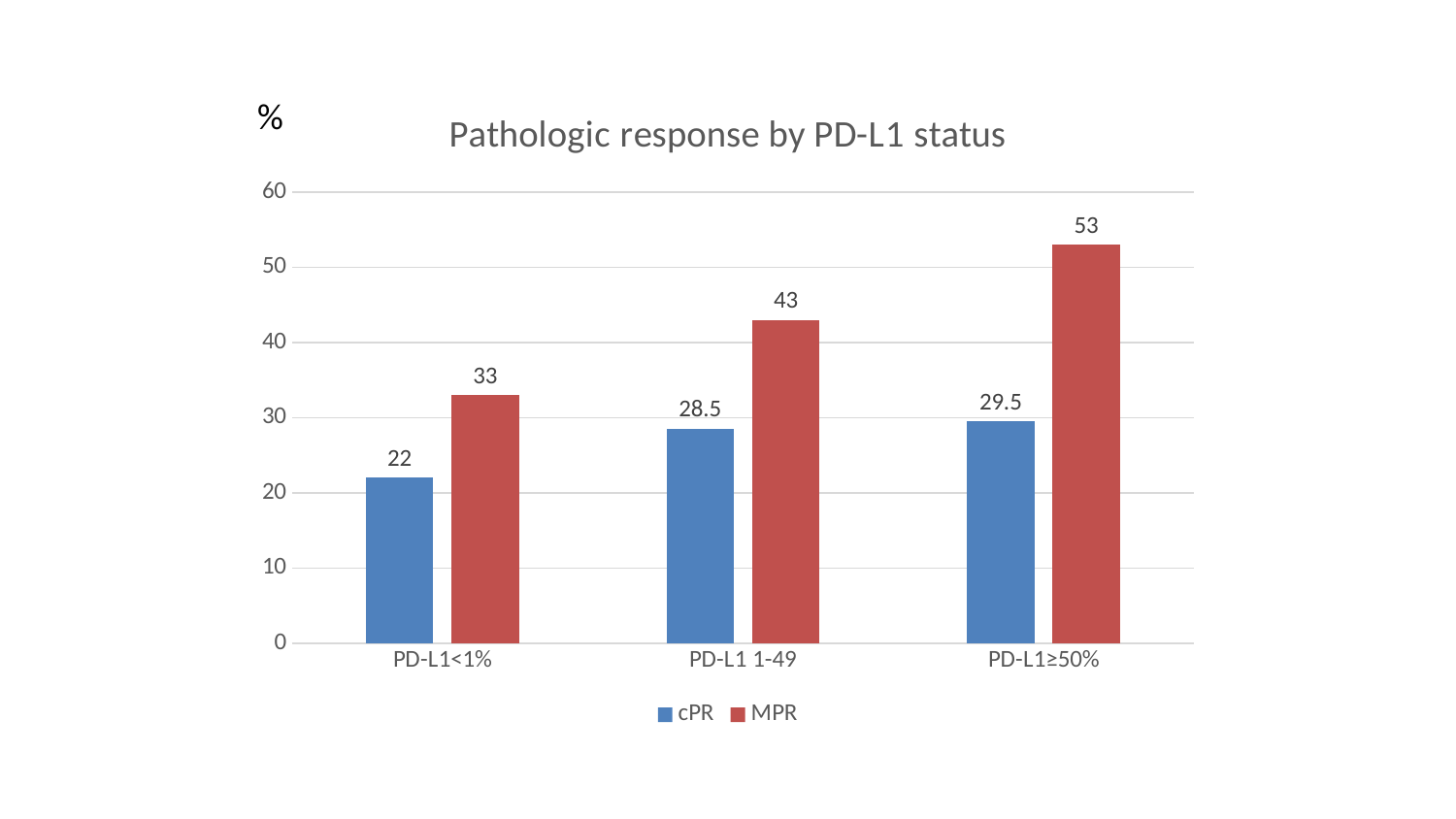
What is the difference between the MPR and cPR values for PD-L1≥50%? 23.5 What is the MPR value for PD-L1≥50%? 53 What is the cPR value for PD-L1 1-49? 28.5 How many PD-L1 categories are shown on the x axis? 3 Which PD-L1 category has the lowest cPR value? PD-L1<1% What is the cPR value for PD-L1<1%? 22 How many series does the legend list? 2 What is the MPR value for PD-L1<1%? 33 Do the MPR values rise or fall from PD-L1<1% to PD-L1≥50%? Rise What kind of chart is shown on the slide? Bar chart Which is larger for PD-L1 1-49, the cPR value or the MPR value? MPR Which PD-L1 category has the highest MPR value? PD-L1≥50%